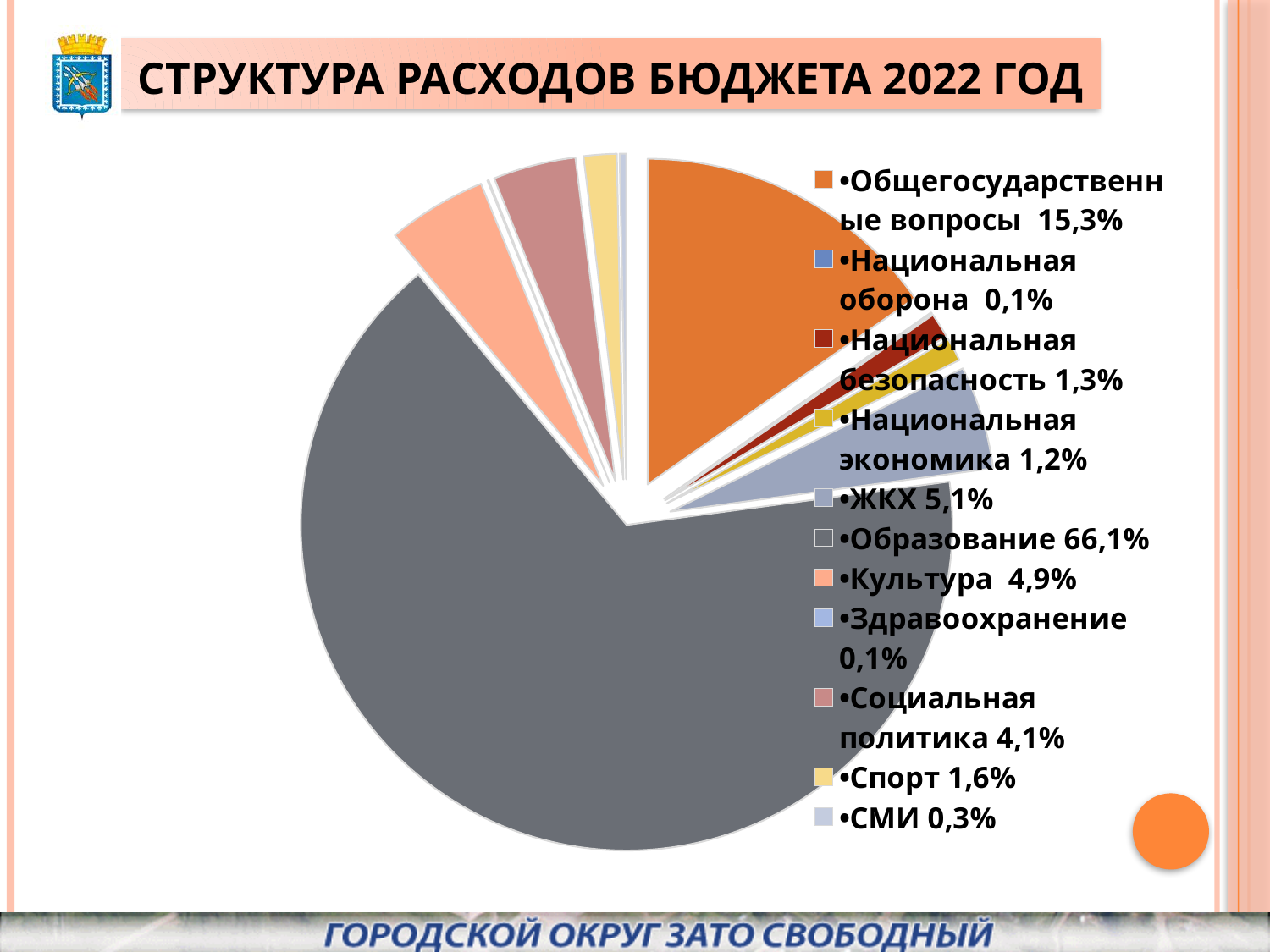
How many categories does the pie chart legend list? 11 Which category has the largest share of the budget expenditure? Образование Which has a larger share, Национальная безопасность or Национальная экономика? Национальная безопасность Which has a larger share, Культура or Социальная политика? Культура What is the share for ЖКХ? 5,1% What type of chart is shown on the slide? Pie chart What share of the budget expenditure goes to Общегосударственные вопросы? 15,3% What is the title of the chart on the slide? СТРУКТУРА РАСХОДОВ БЮДЖЕТА 2022 ГОД What is the share for Спорт? 1,6% What is the difference in percentage points between Образование and Общегосударственные вопросы? 50,8 What share of the budget expenditure goes to Образование? 66,1% What is the share for Социальная политика? 4,1%